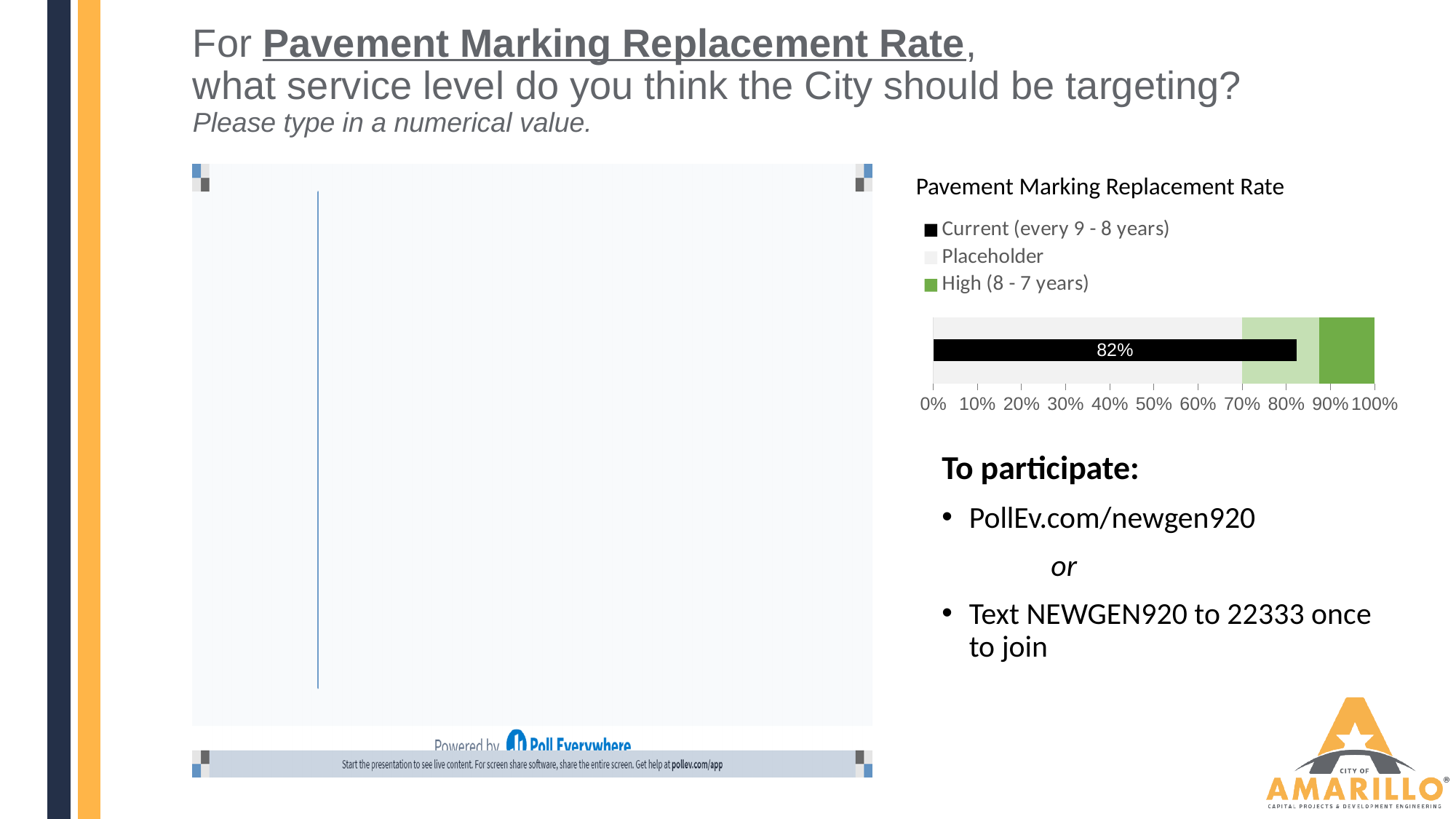
How many data labels are printed on the bars of the Pavement Marking Replacement Rate chart? 1 In the Pavement Marking Replacement Rate chart, what value is printed on the black bar? 82% In the Pavement Marking Replacement Rate chart, is the value of the black Current bar greater or less than 90%? less In the Pavement Marking Replacement Rate chart, is the value of the black Current bar greater or less than 50%? greater What is the title of the chart on the right side of the slide? Pavement Marking Replacement Rate In the Pavement Marking Replacement Rate chart, is the value of the black Current bar greater or less than 80%? greater How many series does the legend of the Pavement Marking Replacement Rate chart list? 3 What kind of chart is the Pavement Marking Replacement Rate chart? bar chart In the Pavement Marking Replacement Rate chart, which legend entry is shown in black? Current (every 9 - 8 years)